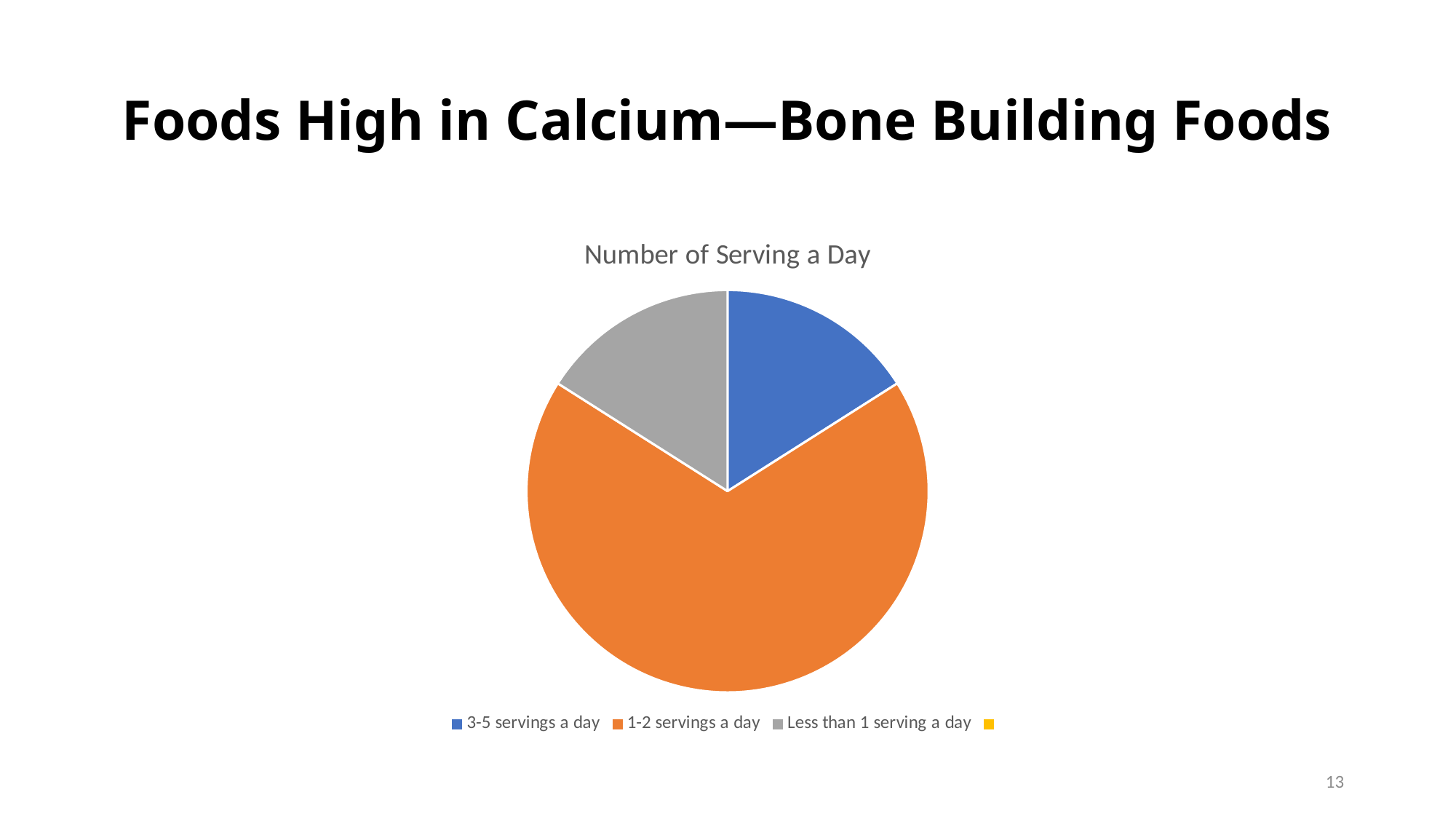
Which colour represents 1-2 servings a day in the pie chart? Orange What kind of chart is shown on the slide? Pie chart Which is larger, the slice for 1-2 servings a day or the slice for 3-5 servings a day? 1-2 servings a day Which is larger, the slice for 1-2 servings a day or the slice for Less than 1 serving a day? 1-2 servings a day What is the title of the chart? Number of Serving a Day How many slices are visible in the pie chart? 3 Which category has the largest slice of the pie? 1-2 servings a day How many labelled entries does the legend list? 3 Does the slice for 1-2 servings a day take up more or less than half of the pie? More